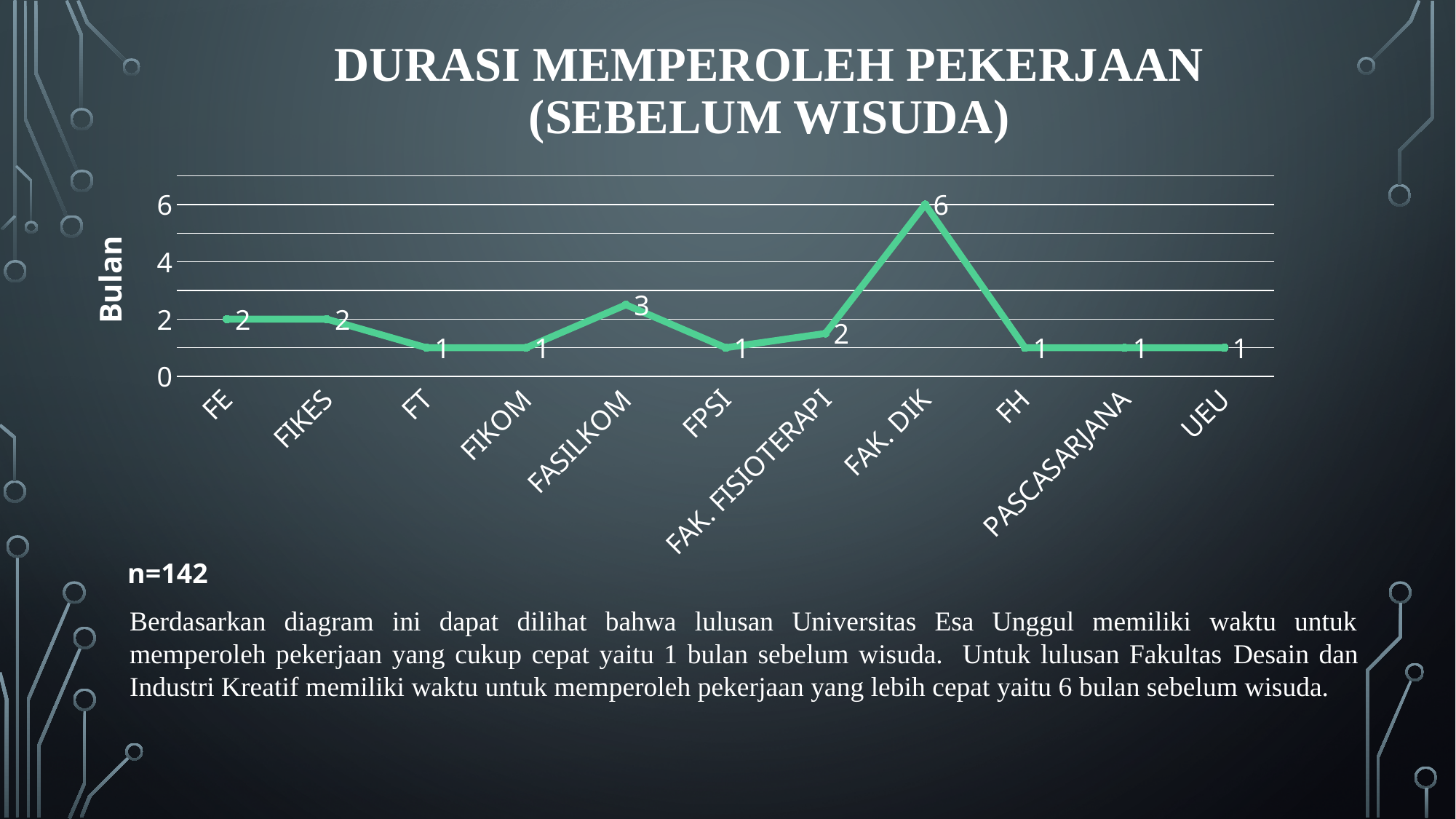
How many categories are shown on the x axis? 11 Which category has the highest value? FAK. DIK What is the value for UEU? 1 Which is larger, the value for FE or the value for FT? FE What is the label of the y axis? Bulan What is the title of the chart? DURASI MEMPEROLEH PEKERJAAN (SEBELUM WISUDA) Is the value for FAK. DIK greater or less than 4? greater What type of chart is shown on the slide? line chart What is the value for FASILKOM? 3 What is the value for FAK. FISIOTERAPI? 2 What is the value for FAK. DIK? 6 What is the difference between the values for FAK. DIK and FASILKOM? 3